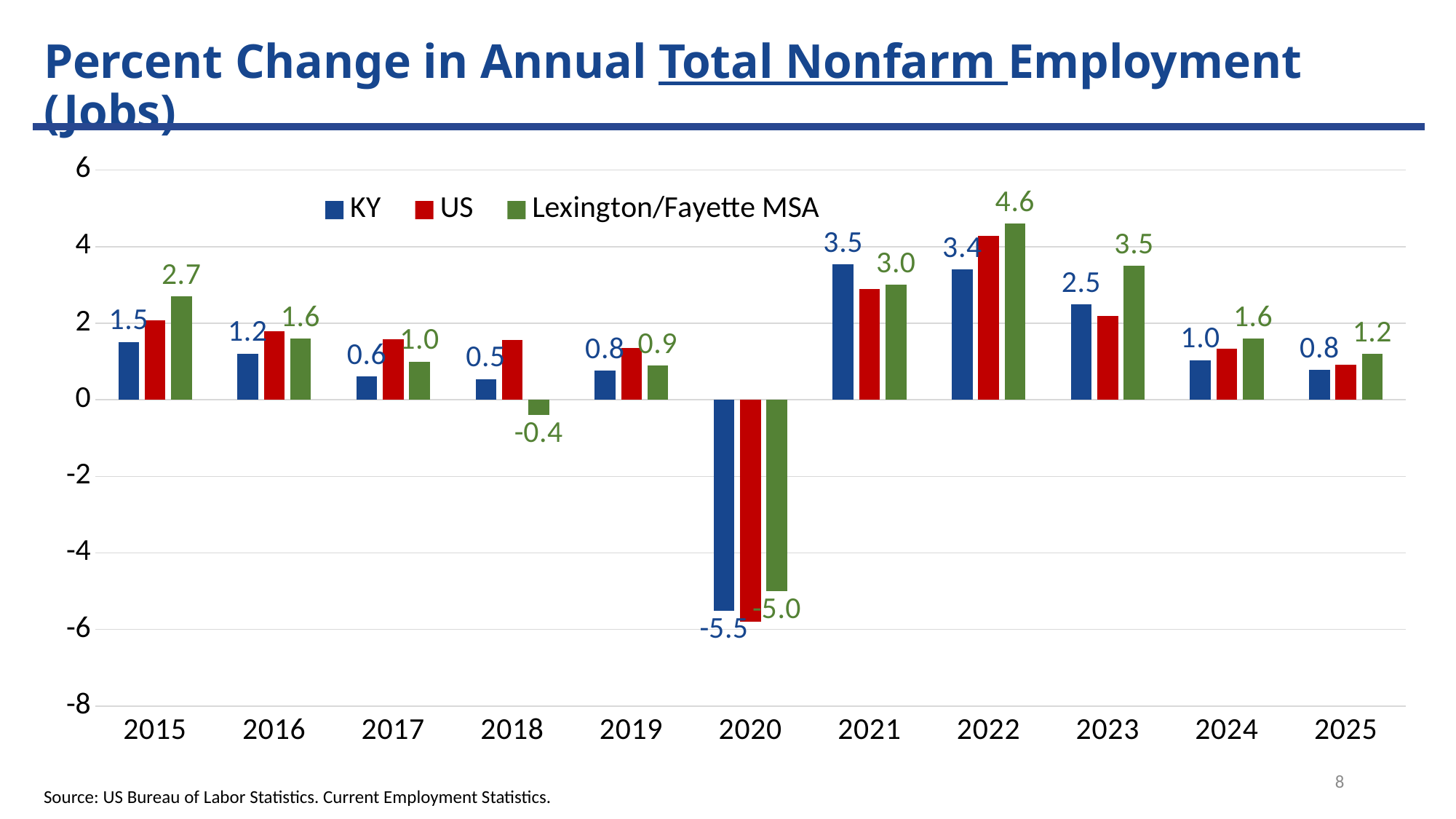
How many series does the legend list? 3 What is the value for Lexington/Fayette MSA in 2018? -0.4 In which year is the Lexington/Fayette MSA value highest? 2022 What is the difference between the Lexington/Fayette MSA value and the KY value in 2022? 1.2 What is the value for KY in 2020? -5.5 How many years are shown on the x axis? 11 What kind of chart is shown on the slide? Bar chart Is the value for US in 2020 greater or less than -4? less What is the value for KY in 2021? 3.5 Which is larger in 2015, the KY value or the Lexington/Fayette MSA value? Lexington/Fayette MSA In which year is the KY value lowest? 2020 Is the value for US in 2022 greater or less than 4? greater